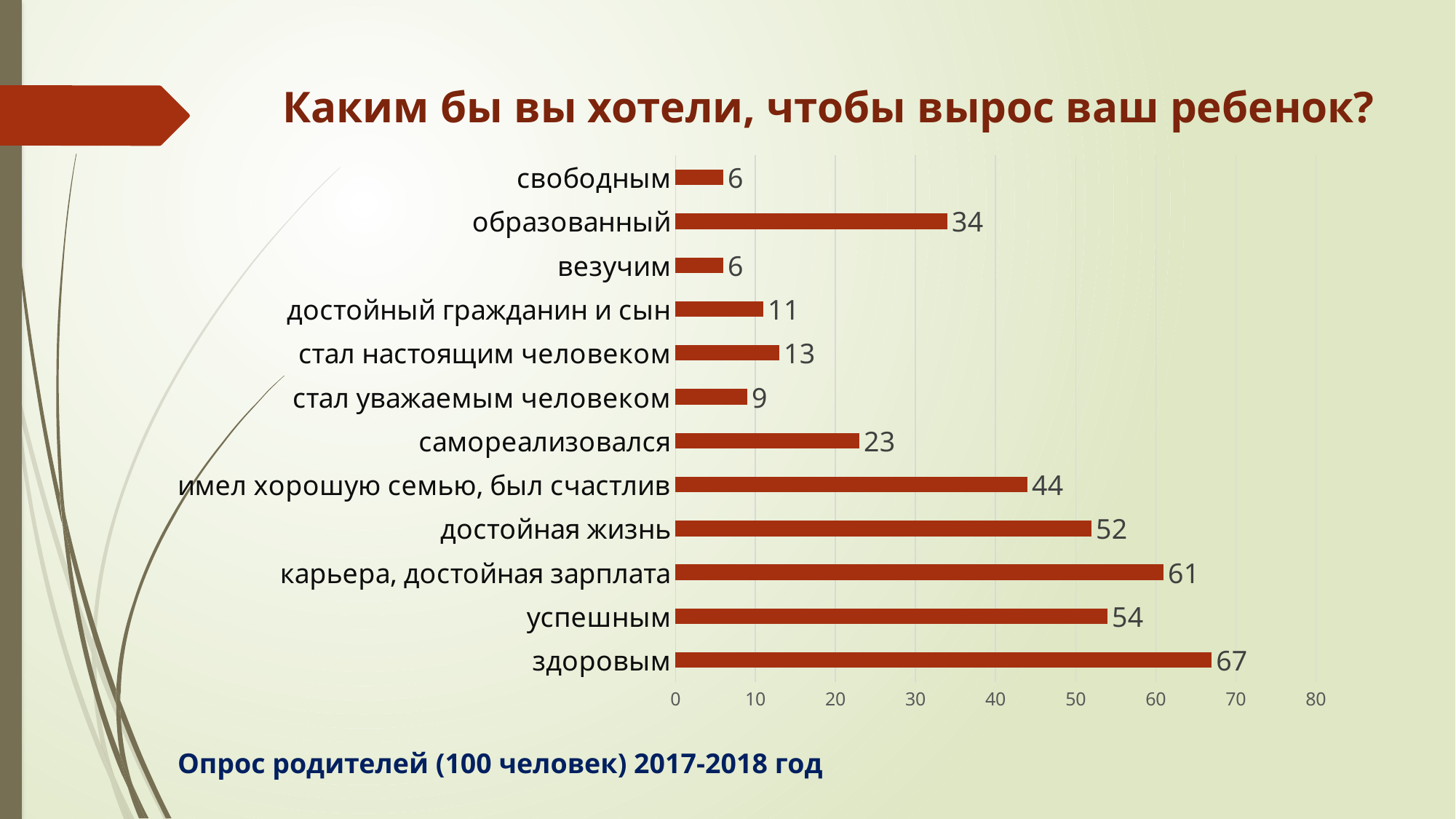
What is the title of the chart? Каким бы вы хотели, чтобы вырос ваш ребенок? How many categories are shown in the chart? 12 What is the difference between the values for "здоровым" and "свободным"? 61 What is the difference between the values for "карьера, достойная зарплата" and "успешным"? 7 What is the value for "стал уважаемым человеком"? 9 What is the value for "самореализовался"? 23 What kind of chart is shown on the slide? bar chart Which is larger: the value for "достойная жизнь" or the value for "имел хорошую семью, был счастлив"? достойная жизнь Is the value for "стал настоящим человеком" greater or less than 20? less Which category has the highest value? здоровым What is the value for "образованный"? 34 What is the value for "здоровым"? 67